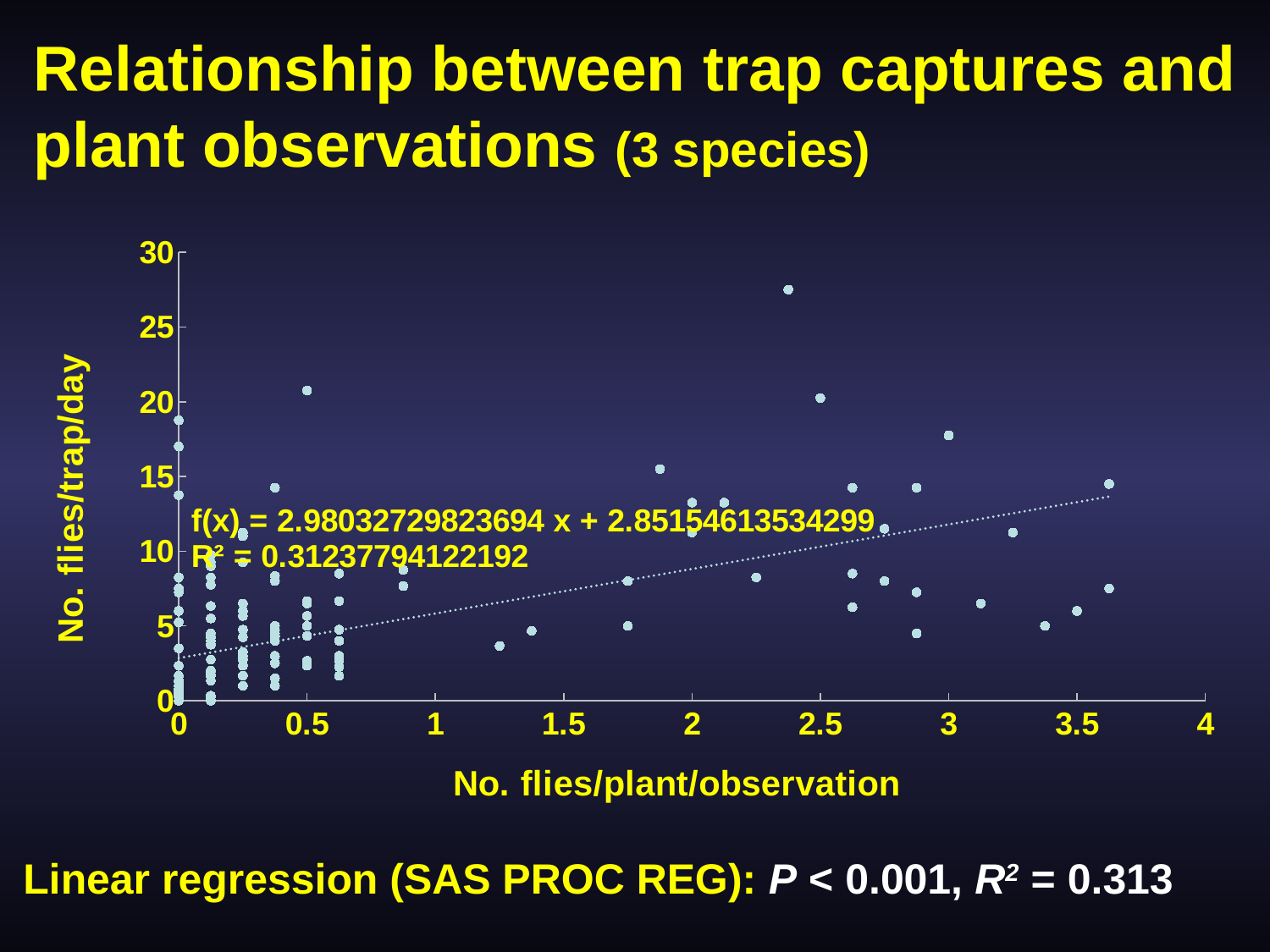
Is the plotted point near x = 3 with the highest y value greater or less than 15 flies/trap/day? greater Is the x value of the highest plotted point greater or less than 2? greater What is the title of the x axis? No. flies/plant/observation What is the slope (coefficient of x) in the regression equation printed on the chart? 2.98032729823694 What kind of chart is shown on the slide? scatter chart Is the highest plotted point on the chart greater or less than 25 flies/trap/day? greater What is the intercept in the regression equation printed on the chart? 2.85154613534299 What is the title of the y axis? No. flies/trap/day What R² value is printed on the chart next to the regression equation? 0.31237794122192 Does the fitted trend line rise or fall as No. flies/plant/observation increases? rises What is the maximum value shown on the y axis? 30